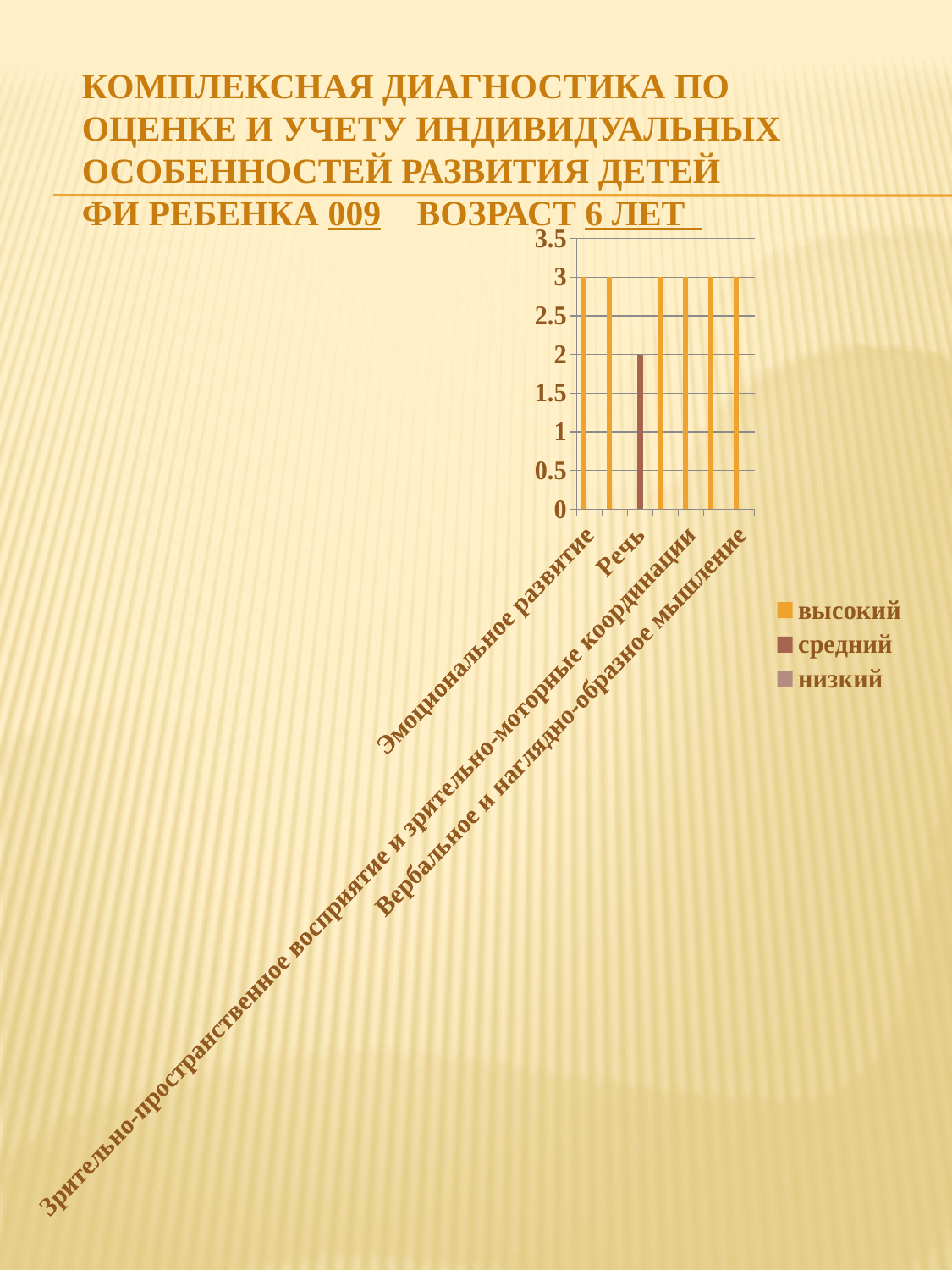
What kind of chart is shown on the slide? bar chart How many series does the legend list? 3 Which legend series does the bar for Речь belong to? средний What is the highest value shown on the vertical axis? 3.5 What is the value for Вербальное и наглядно-образное мышление? 3 How many bars are plotted on the chart? 7 What is the value for Эмоциональное развитие? 3 What is the value for Речь? 2 What is the difference between the value for Эмоциональное развитие and the value for Речь? 1 Is the value for Речь greater or less than 2.5? less Which is larger, the value for Эмоциональное развитие or the value for Речь? Эмоциональное развитие Which category has the lowest value? Речь